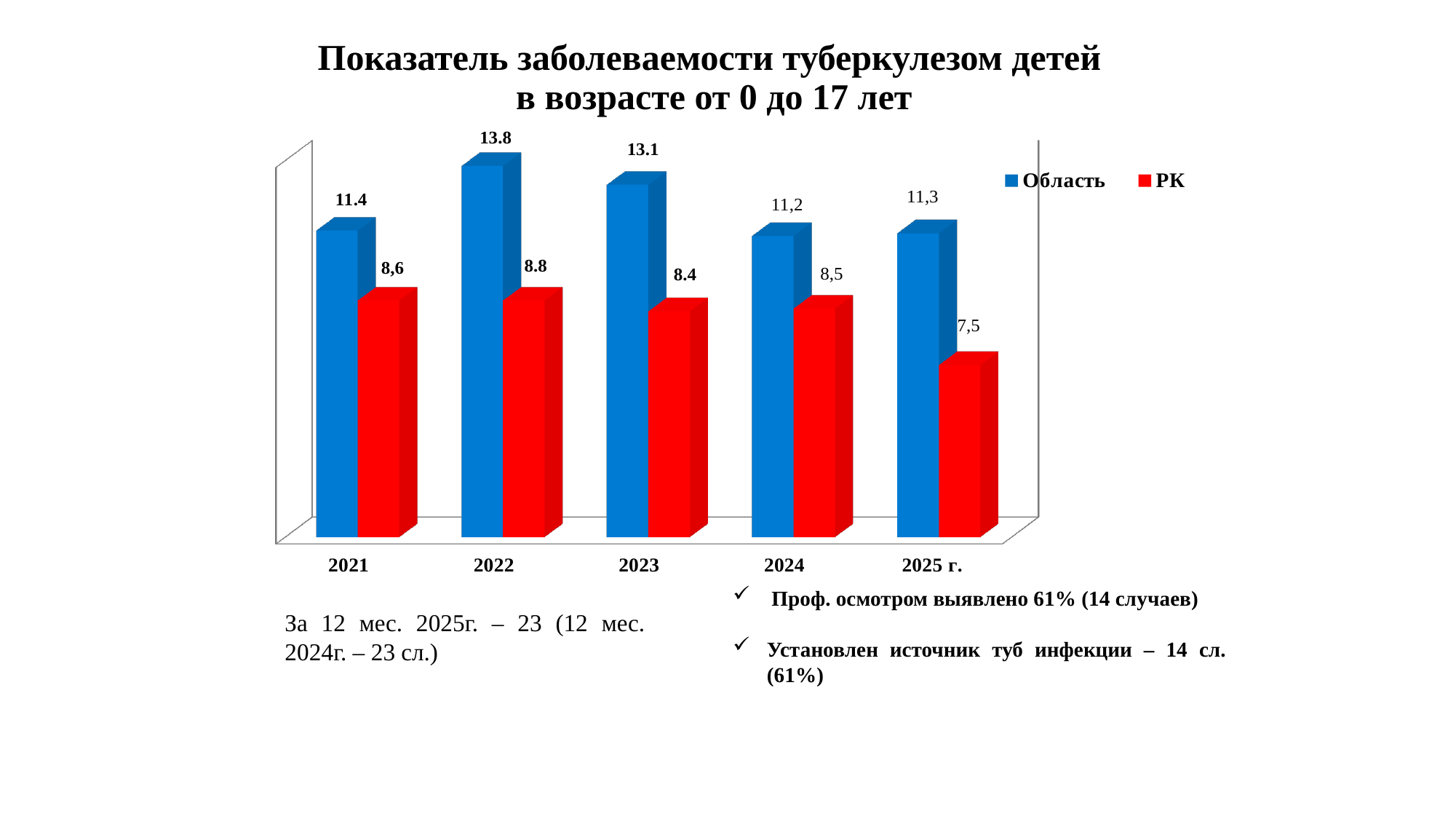
What is the value for Область in 2022? 13.8 In which year is the РК value lowest? 2025 г. What is the value for РК in 2025 г.? 7,5 How many series does the legend list? 2 What is the value for Область in 2024? 11,2 How many years are shown on the x axis? 5 What kind of chart is shown on the slide? Bar chart What is the value for РК in 2023? 8.4 What is the difference between the Область and РК values in 2022? 5 What is the difference between the Область and РК values in 2025 г.? 3,8 Which is larger in 2021, the Область value or the РК value? Область In which year is the Область value highest? 2022